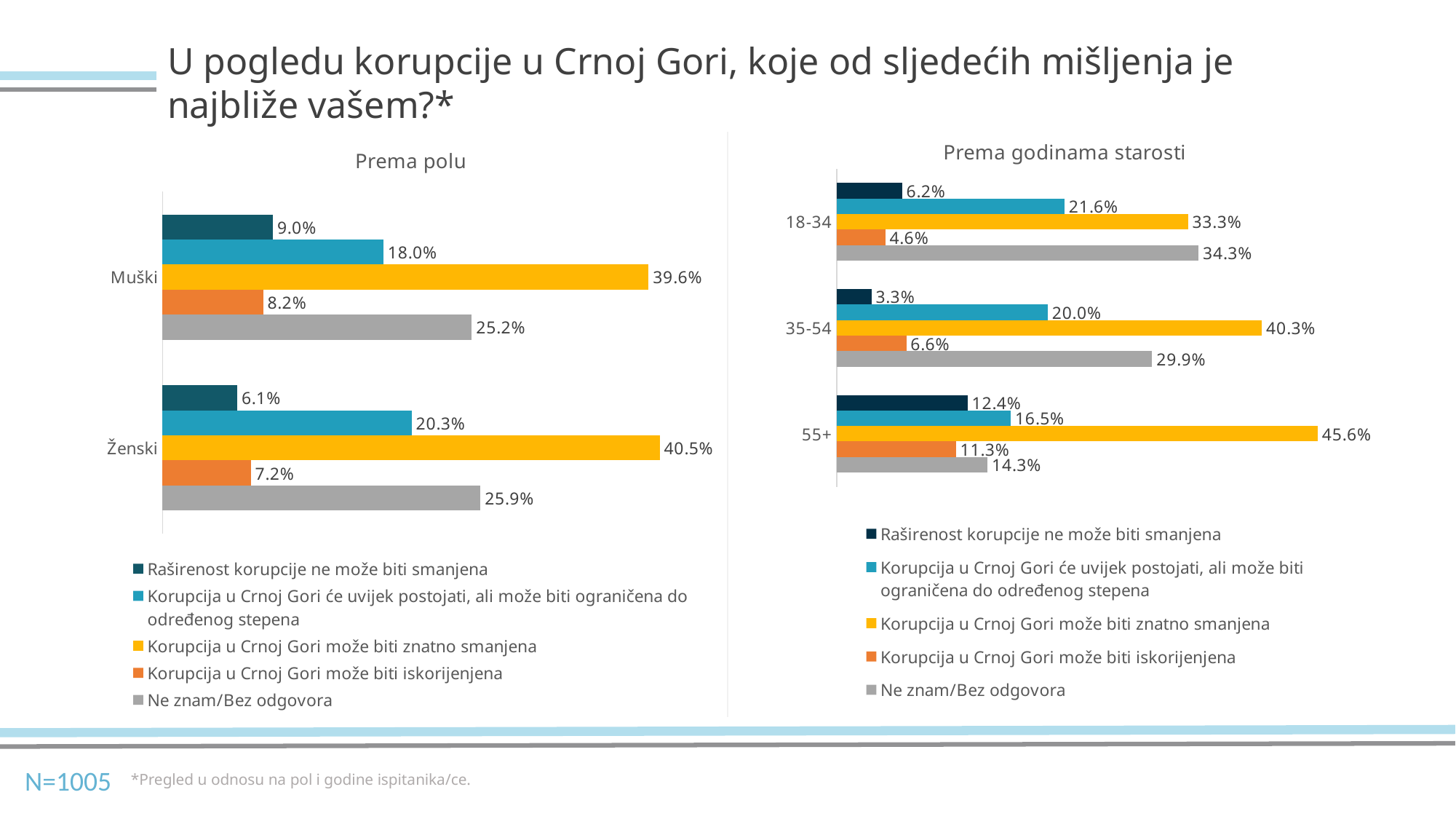
In the 'Prema godinama starosti' chart, what is the value for 'Korupcija u Crnoj Gori može biti iskorijenjena' for 18-34? 4.6% How many series does the legend of the 'Prema polu' chart list? 5 In the 'Prema polu' chart, which is larger: the 'Raširenost korupcije ne može biti smanjena' value for Muški or for Ženski? Muški In the 'Prema polu' chart, what is the value for 'Korupcija u Crnoj Gori može biti znatno smanjena' for Muški? 39.6% In the 'Prema godinama starosti' chart, which age group has the highest value for 'Korupcija u Crnoj Gori može biti znatno smanjena'? 55+ In the 'Prema polu' chart, what is the value for 'Ne znam/Bez odgovora' for Ženski? 25.9% In the 'Prema polu' chart, what is the difference between the 'Korupcija u Crnoj Gori može biti znatno smanjena' values for Ženski and Muški? 0.9% In the 'Prema godinama starosti' chart, which age group has the lowest value for 'Ne znam/Bez odgovora'? 55+ How many age groups are shown in the 'Prema godinama starosti' chart? 3 In the 'Prema godinama starosti' chart, what is the difference between the 'Ne znam/Bez odgovora' values for 18-34 and 55+? 20.0% What type of chart is the 'Prema polu' chart? Bar chart In the 'Prema godinama starosti' chart, what is the value for 'Raširenost korupcije ne može biti smanjena' for 55+? 12.4%